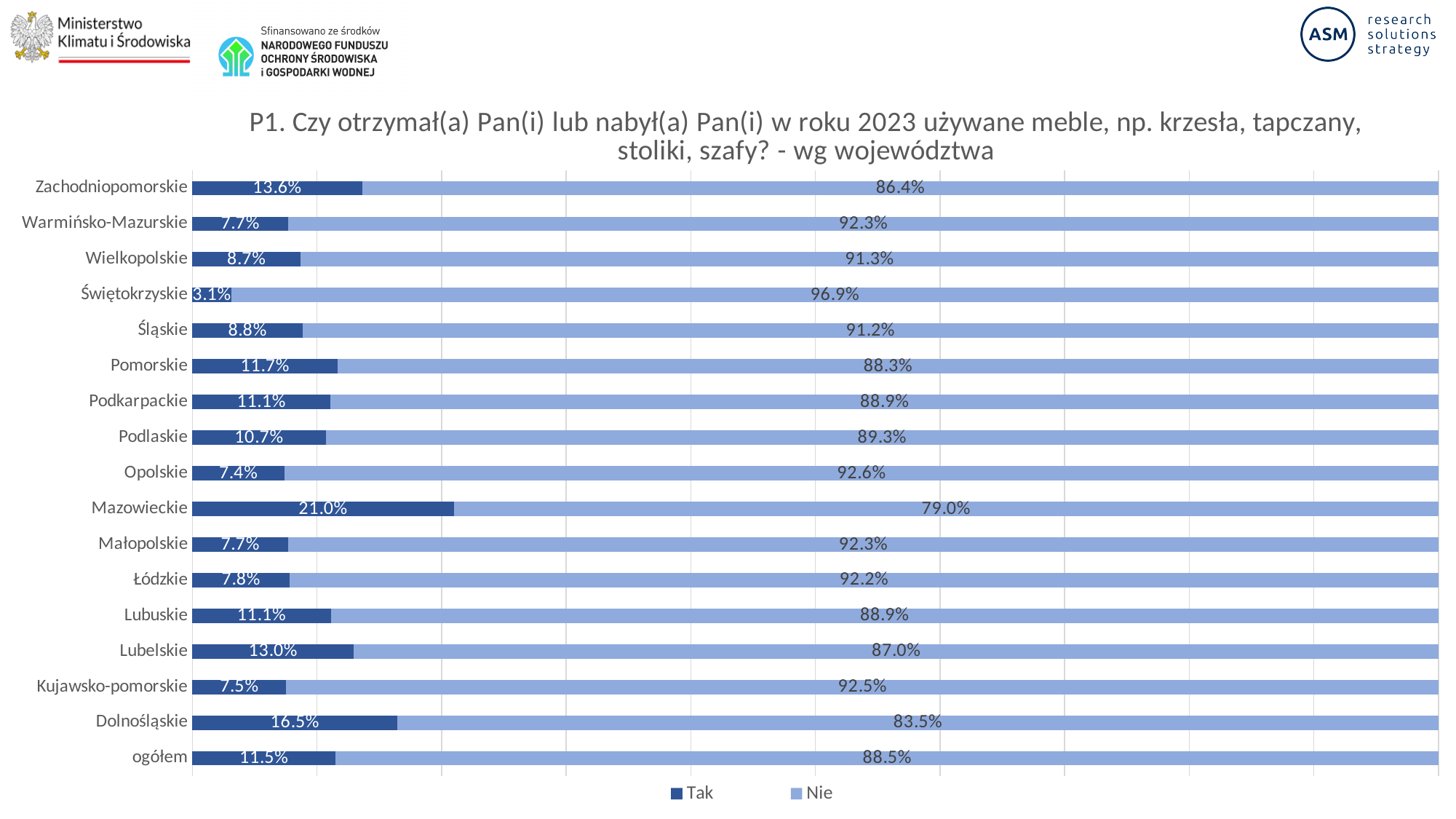
How many categories (rows) are shown on the chart? 17 What is the "Tak" value for Mazowieckie? 21.0% Which voivodeship has the highest "Tak" value? Mazowieckie How many series does the legend list? 2 Which voivodeship has the lowest "Tak" value? Świętokrzyskie What is the "Tak" value for ogółem? 11.5% What is the "Nie" value for Świętokrzyskie? 96.9% Which has a larger "Tak" value, Zachodniopomorskie or Pomorskie? Zachodniopomorskie What are the two legend entries of the chart? Tak, Nie What is the difference between the "Tak" values for Dolnośląskie and Lubelskie? 3.5% What is the total of the stacked bar for Opolskie? 100.0% What kind of chart is shown on the slide? Stacked bar chart